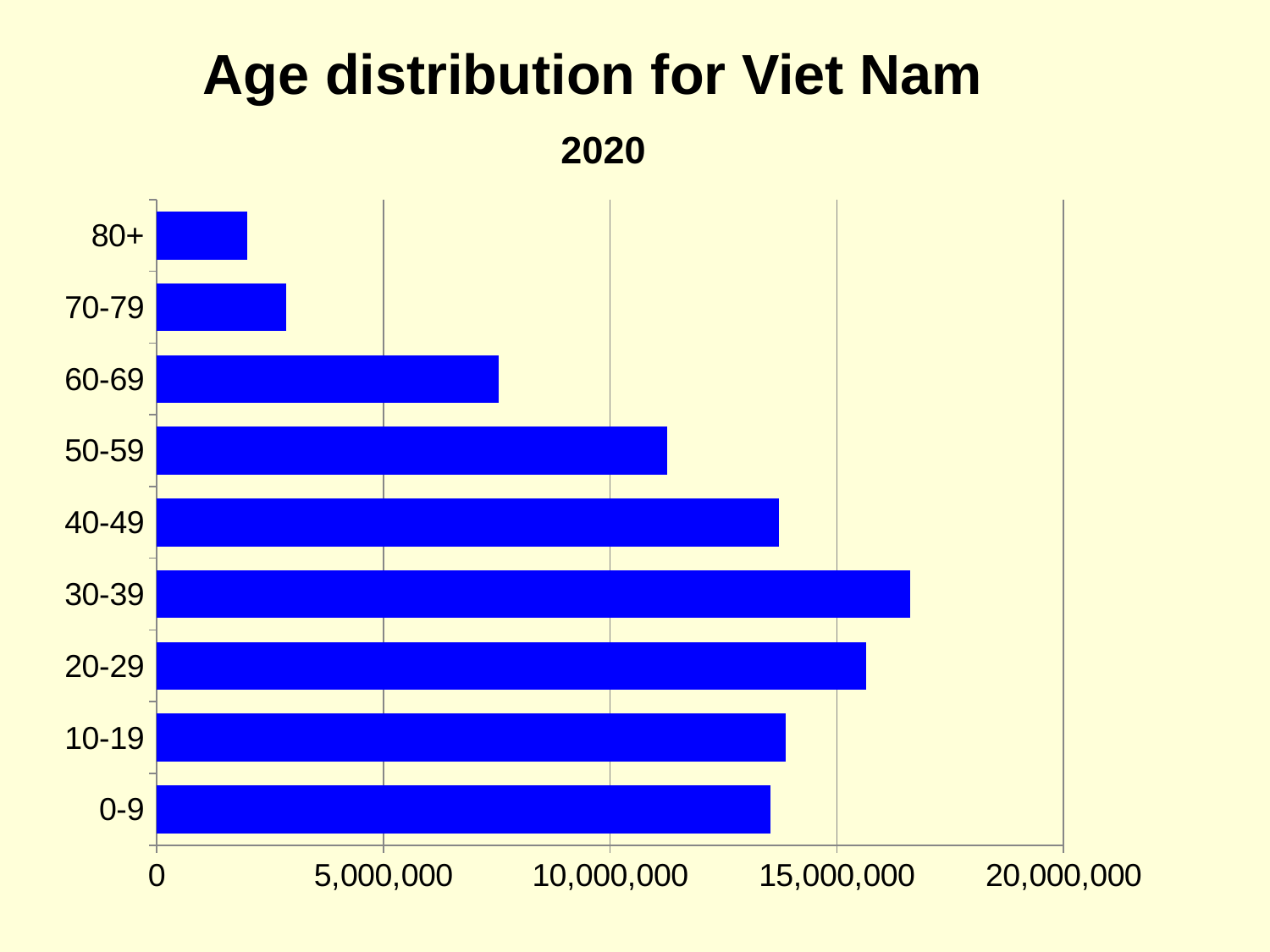
Is the value for the 50-59 age group greater or less than 10,000,000? greater What kind of chart is shown on the slide? bar chart Which is larger, the value for the 20-29 age group or the 40-49 age group? 20-29 Is the value for the 60-69 age group greater or less than 5,000,000? greater Which age group has the lowest value? 80+ Is the value for the 80+ age group greater or less than 5,000,000? less Which is larger, the value for the 60-69 age group or the 70-79 age group? 60-69 How many age groups are shown in the chart? 9 Which age group has the highest value? 30-39 What year does the chart's subtitle give? 2020